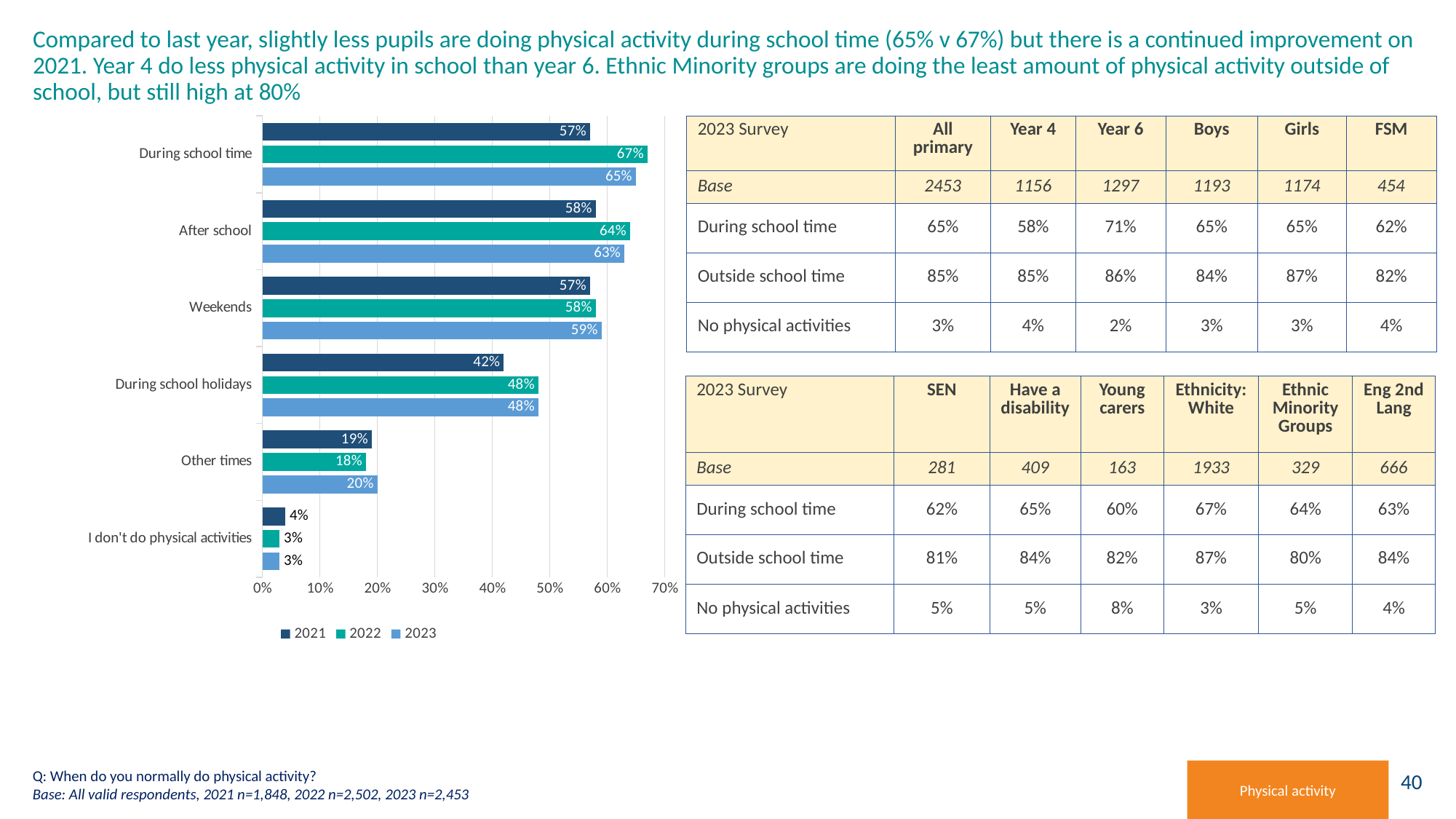
What is the 2021 value for 'During school holidays'? 42% How many series does the legend list? 3 Which is larger for 'Other times': the 2021 value or the 2023 value? 2023 What is the difference between the 2022 and 2021 values for 'During school time'? 10% Which category has the highest 2022 value? During school time How many categories are shown on the chart? 6 Which years are listed in the chart legend? 2021, 2022, 2023 What is the 2022 value for 'After school'? 64% What is the 2023 value for 'During school time'? 65% What kind of chart is shown on the slide? Bar chart Is the 2023 value for 'Weekends' greater or less than 50%? greater Which category has the lowest 2023 value? I don't do physical activities